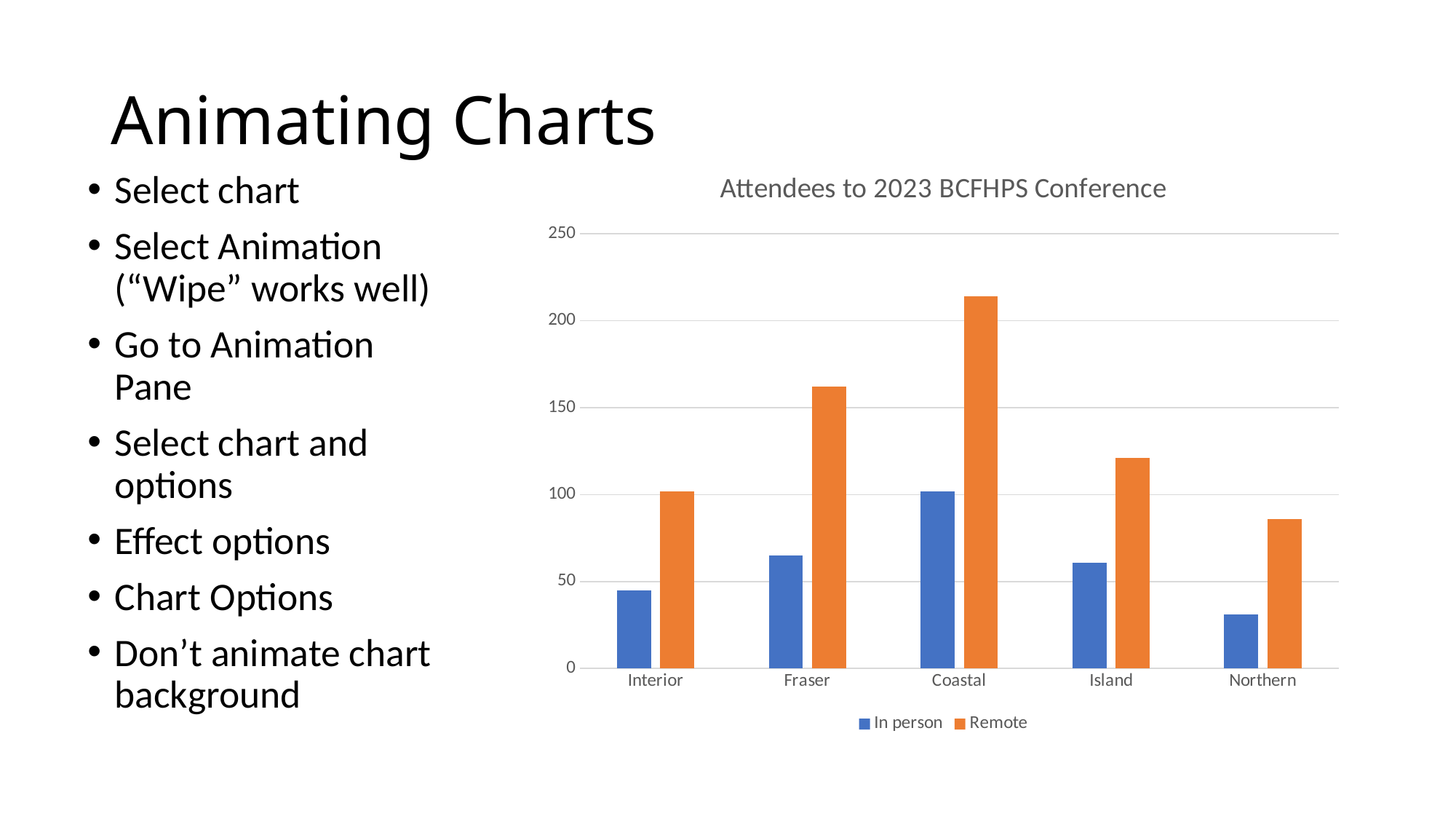
Which is larger, the In person value for Interior or the In person value for Northern? Interior Which category has the highest Remote value? Coastal What is the title of the chart? Attendees to 2023 BCFHPS Conference How many categories are shown on the x axis? 5 Which is larger, the Remote value for Fraser or the Remote value for Island? Fraser What type of chart is shown on the slide? Bar chart Which category has the lowest In person value? Northern Is the Remote value for Fraser greater or less than 150? greater Is the Remote value for Coastal greater or less than 200? greater How many series does the legend list? 2 Is the In person value for Northern greater or less than 50? less Which category has the lowest Remote value? Northern